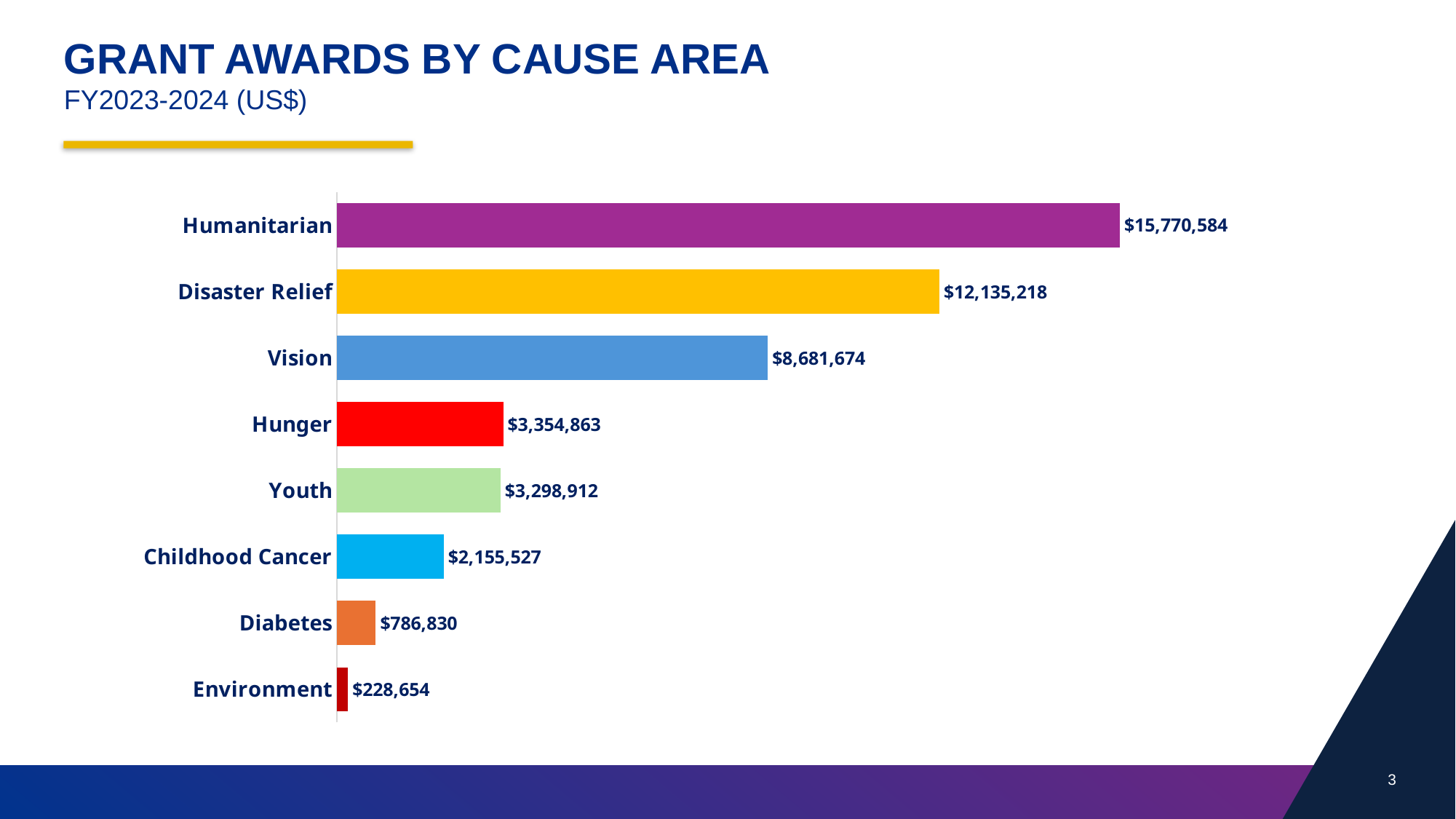
What is the grant award value for Childhood Cancer? $2,155,527 Which cause area received the highest grant award? Humanitarian What is the grant award value for Diabetes? $786,830 Which received a larger grant award, Hunger or Youth? Hunger What kind of chart is shown on the slide? Bar chart How many cause areas are shown in the chart? 8 What is the difference between the Humanitarian and Disaster Relief grant awards? $3,635,366 What is the grant award value for Vision? $8,681,674 Which cause area received the lowest grant award? Environment What fiscal year and currency does the chart subtitle indicate? FY2023-2024 (US$) Which received a larger grant award, Vision or Disaster Relief? Disaster Relief What is the difference between the Diabetes and Environment grant awards? $558,176